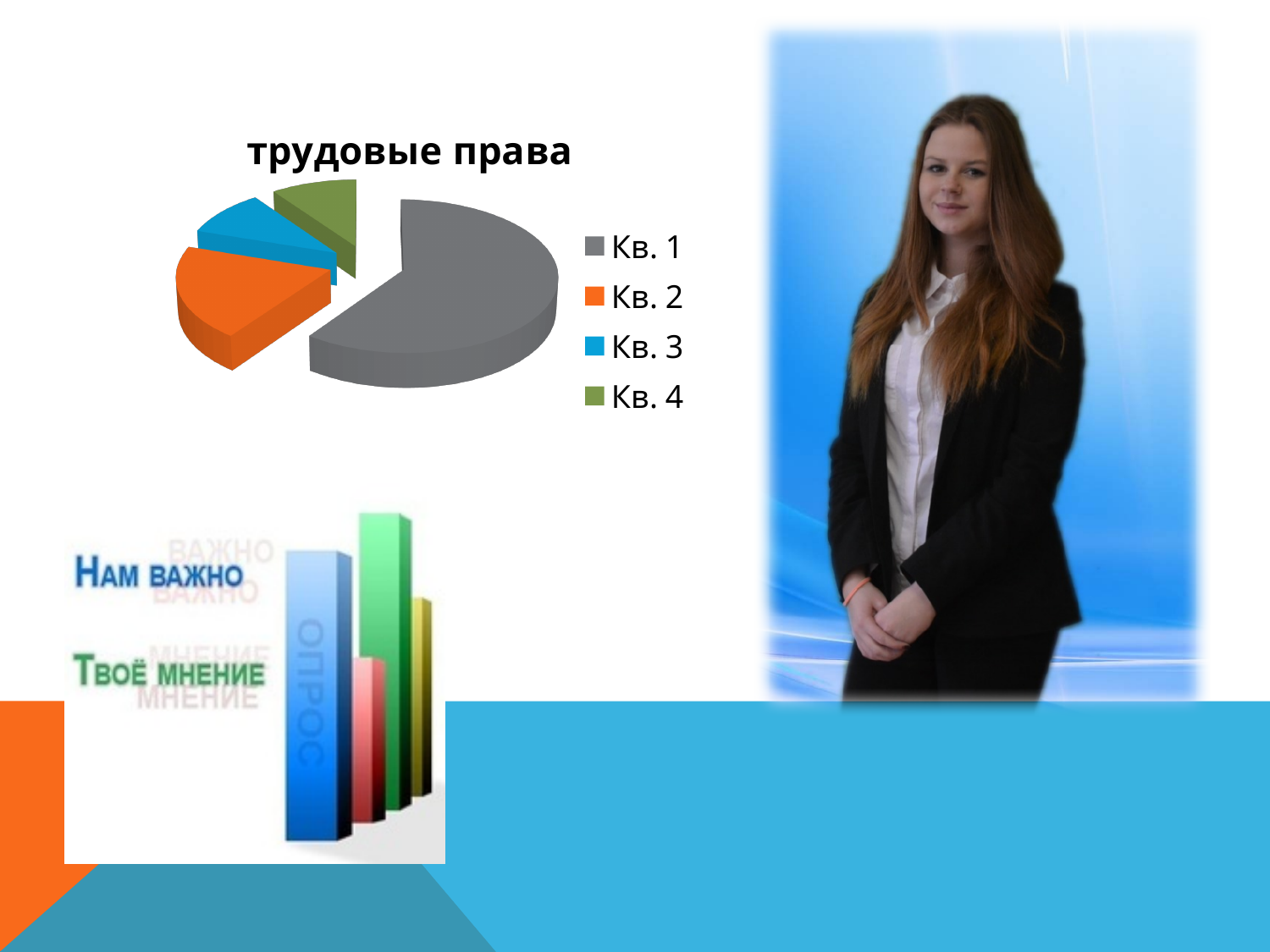
What is the title of the pie chart on the slide? трудовые права In the pie chart "трудовые права", which slice is larger, Кв. 2 or Кв. 4? Кв. 2 What kind of chart is shown under the title "трудовые права"? pie chart In the pie chart "трудовые права", which slice is larger, Кв. 1 or Кв. 2? Кв. 1 How many entries does the legend of the pie chart "трудовые права" list? 4 In the pie chart "трудовые права", which slice is larger, Кв. 2 or Кв. 3? Кв. 2 Which colour represents Кв. 2 in the pie chart "трудовые права"? orange Which category has the largest slice in the pie chart "трудовые права"? Кв. 1 How many slices does the pie chart "трудовые права" have? 4